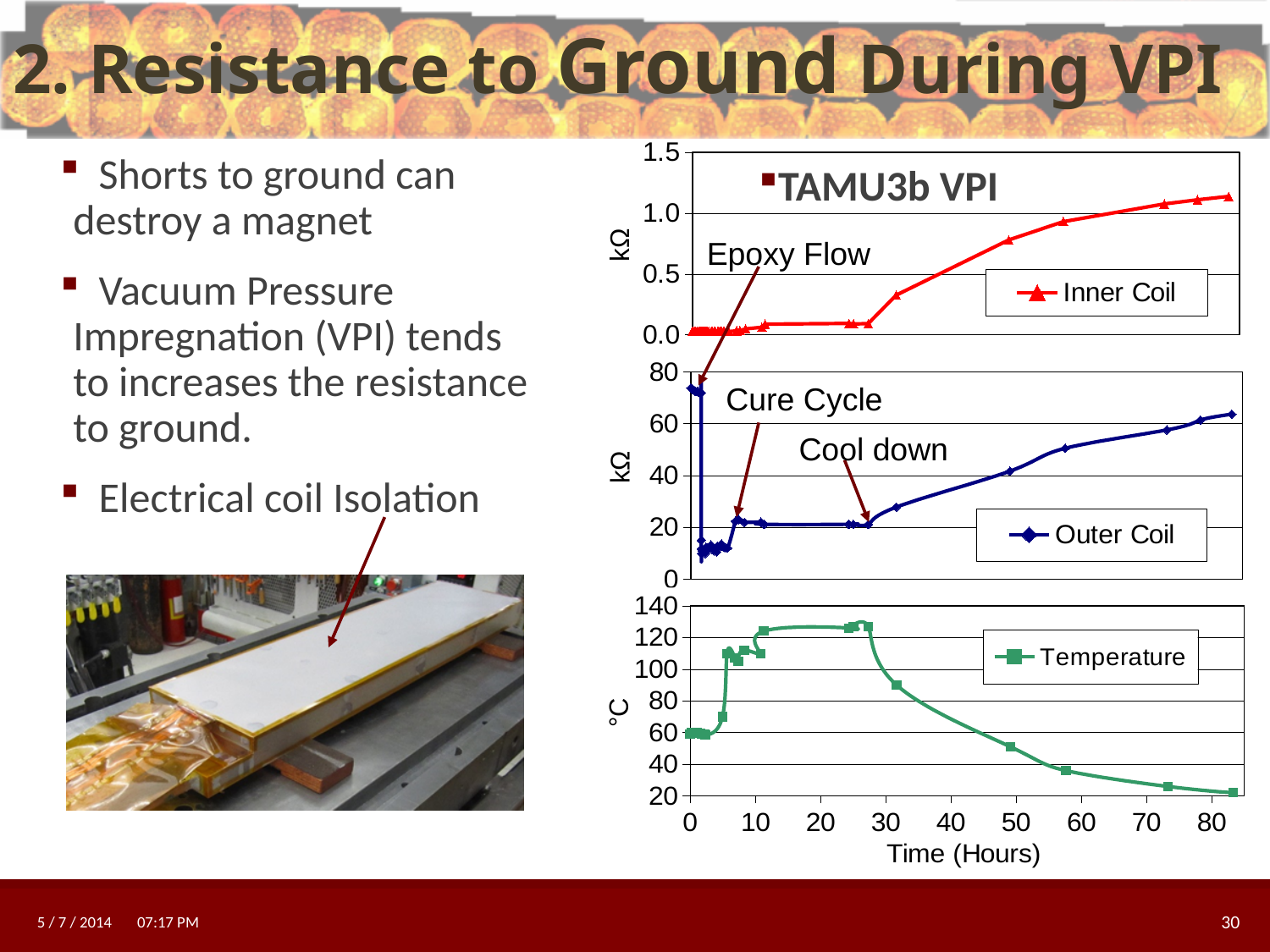
In the Temperature chart, is the value at 20 hours greater or less than 100 °C? greater In the Inner Coil chart, is the value at 80 hours greater or less than 1.0 kΩ? greater What is the label of the shared x axis at the bottom of the charts? Time (Hours) In the Temperature chart, how many series does the legend list? 1 In the Temperature chart, is the value at 80 hours greater or less than 40 °C? less In the Inner Coil chart, does the resistance rise or fall between 30 and 80 hours? rise What kind of chart is used for the Inner Coil data on the slide? line chart What is the title shown at the top of the chart area? TAMU3b VPI In the Temperature chart, does the temperature rise or fall between 30 and 80 hours? fall In the Inner Coil chart, how many series does the legend list? 1